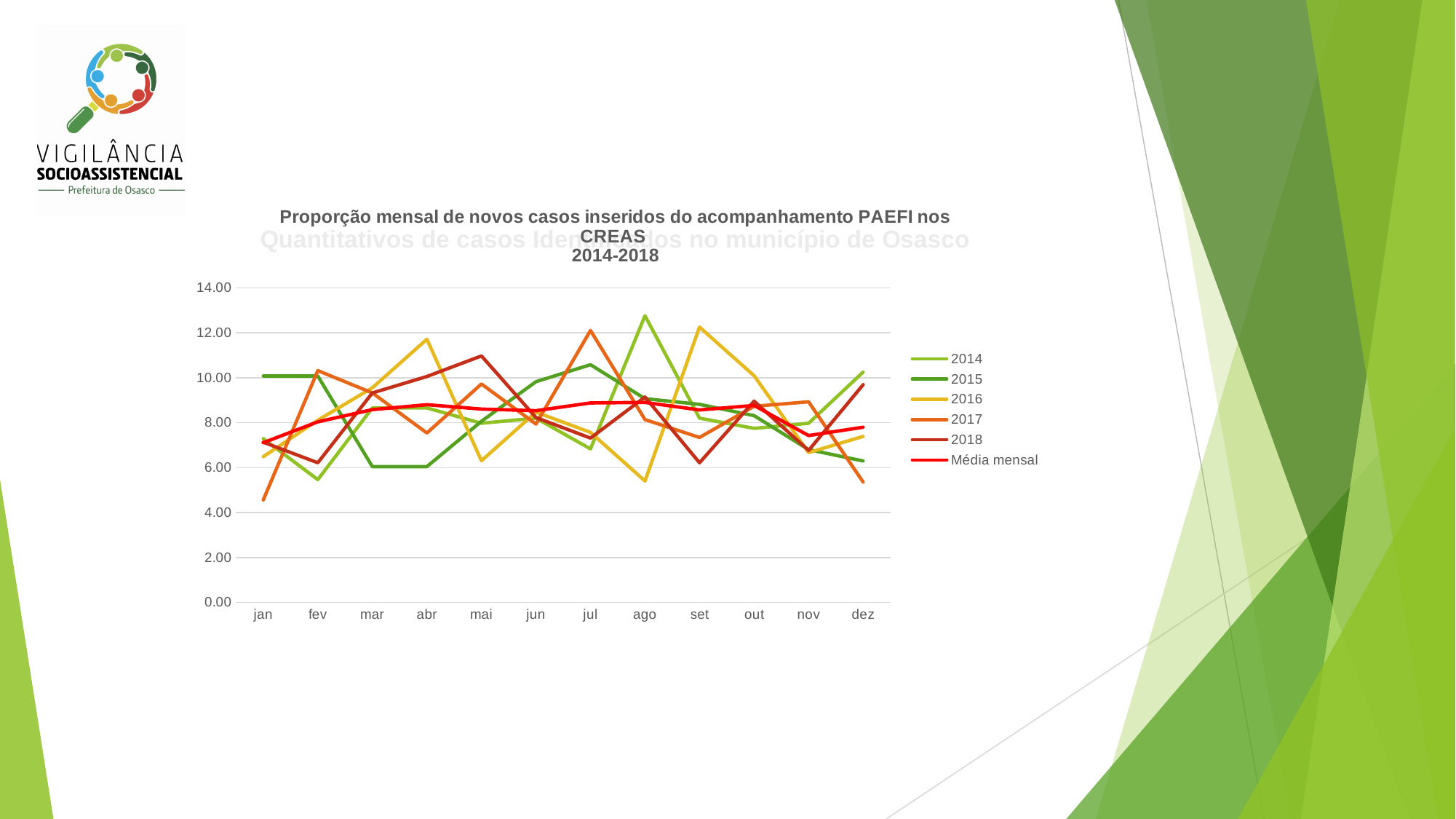
Is the value for 2015 in mar greater or less than 8.00? less How many months are shown along the x axis? 12 Is the value for 2018 in mai greater or less than 10.00? greater Which legend entry is drawn in red? Média mensal Is the value for 2016 in set greater or less than 10.00? greater In which month does the 2017 series reach its lowest value? jan How many series does the legend list? 6 In which month does the 2014 series reach its highest value? ago What kind of chart is shown on the slide? line chart In jan, which series has the larger value, 2015 or 2017? 2015